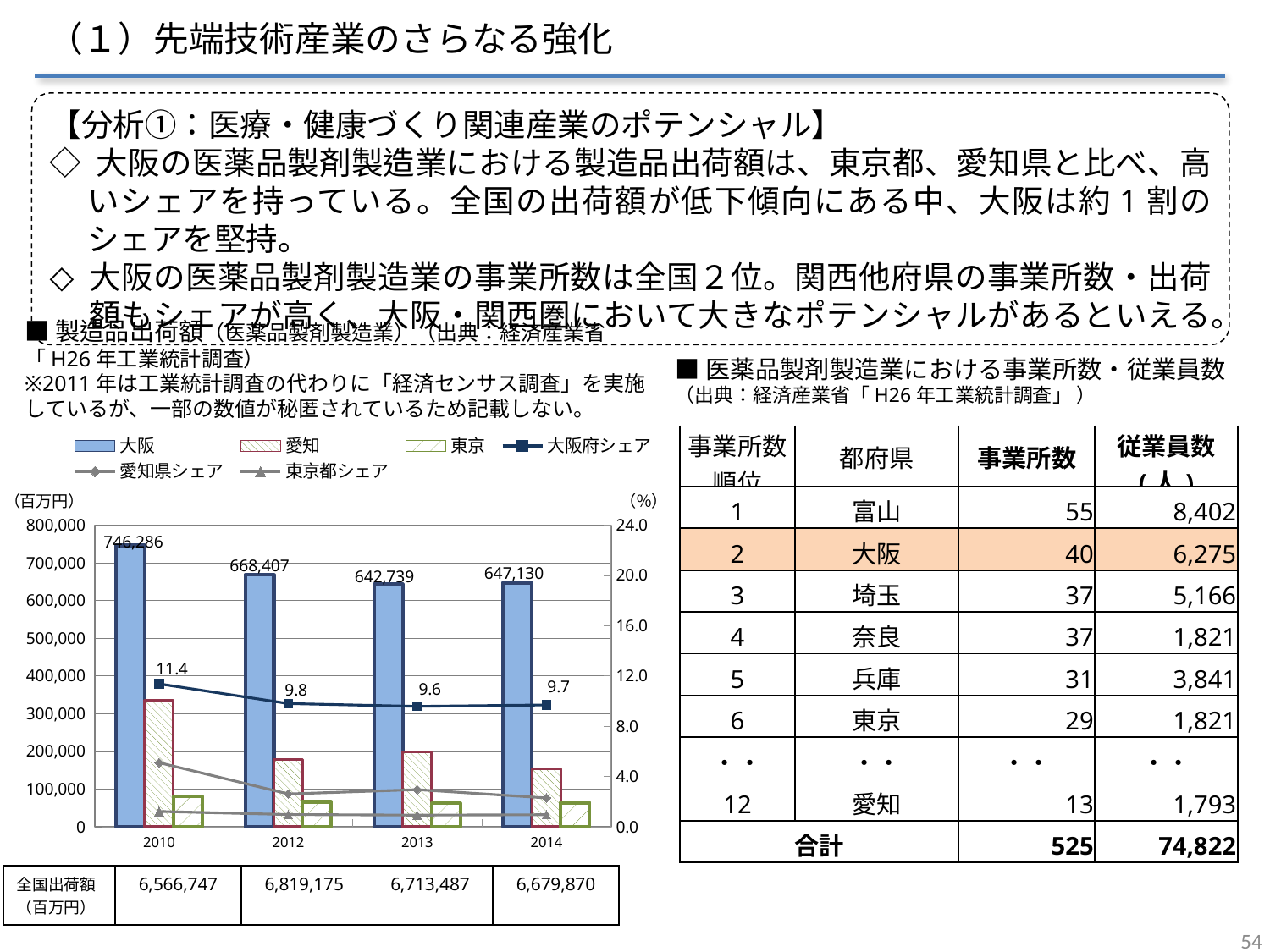
What is the 大阪府シェア value for 2012? 9.8 In which year is the 大阪 bar lowest? 2013 What is the difference between the 大阪 values for 2010 and 2014? 99,156 Does the 大阪府シェア line rise or fall from 2010 to 2014? fall Is the value of the 愛知 bar for 2010 greater or less than 300,000? greater In which year is the 大阪 bar highest? 2010 What kind of chart is shown on the slide? bar chart with line series Which year has the larger 大阪 value, 2012 or 2013? 2012 What is the value of the 大阪 bar for 2010? 746,286 Is the value of the 東京 bar for 2010 greater or less than 100,000? less How many series does the chart legend list? 6 How many years are shown on the x axis of the chart? 4